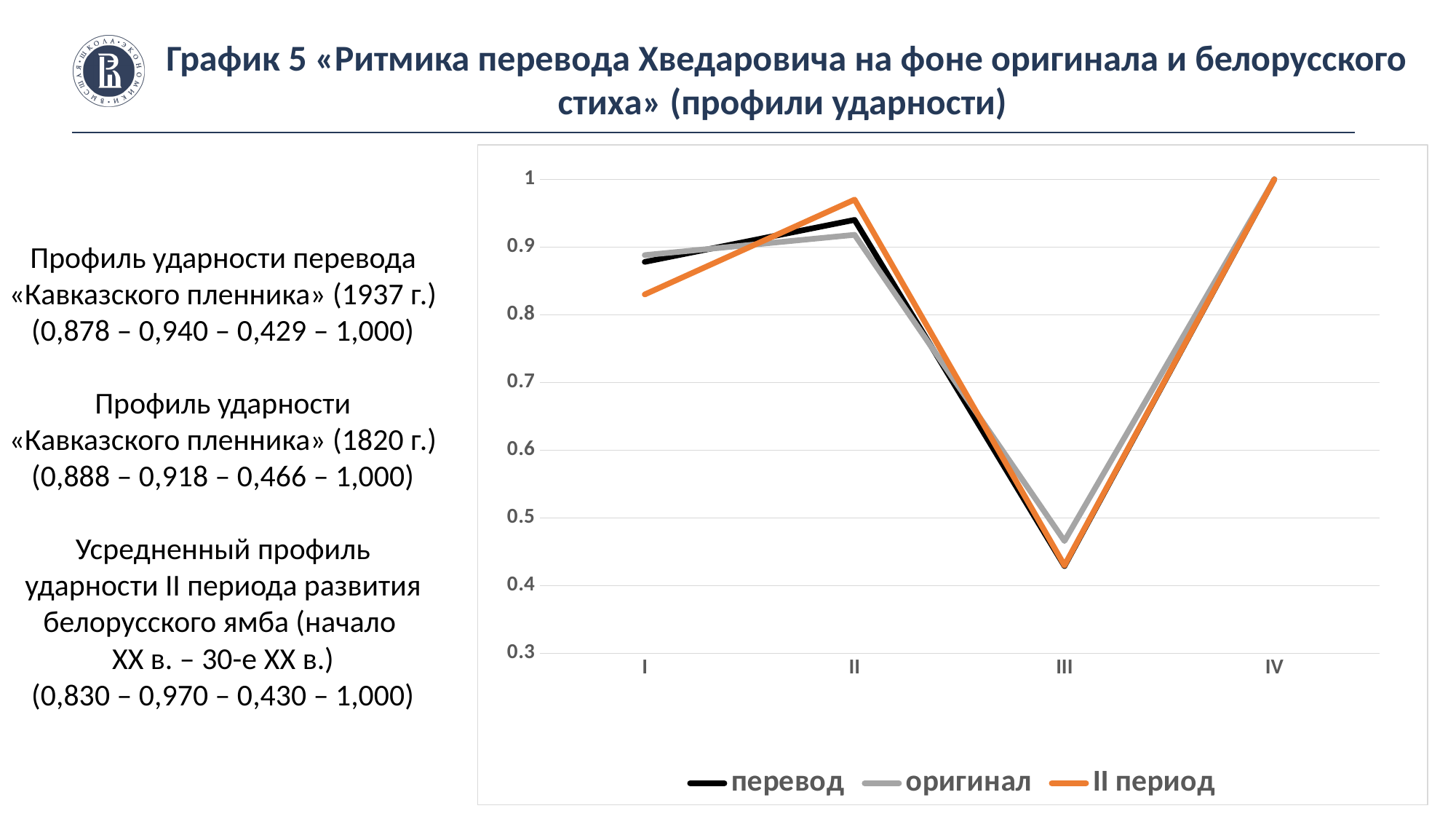
How many points are plotted along the x axis for each series? 4 At which x-axis position does the II период series reach its highest value? IV What is the difference between the оригинал and перевод values at position III? 0,037 Which series has the higher value at position II: перевод or оригинал? перевод How many series does the legend list? 3 What is the value of the оригинал series at position II? 0,918 Which colour is used for the II период series? orange What is the value of the II период series at position I? 0,830 Is the value of the оригинал series at position III greater or less than 0.5? less At which x-axis position does the перевод series reach its lowest value? III What kind of chart is shown on the slide? line chart What is the value of the перевод series at position III? 0,429